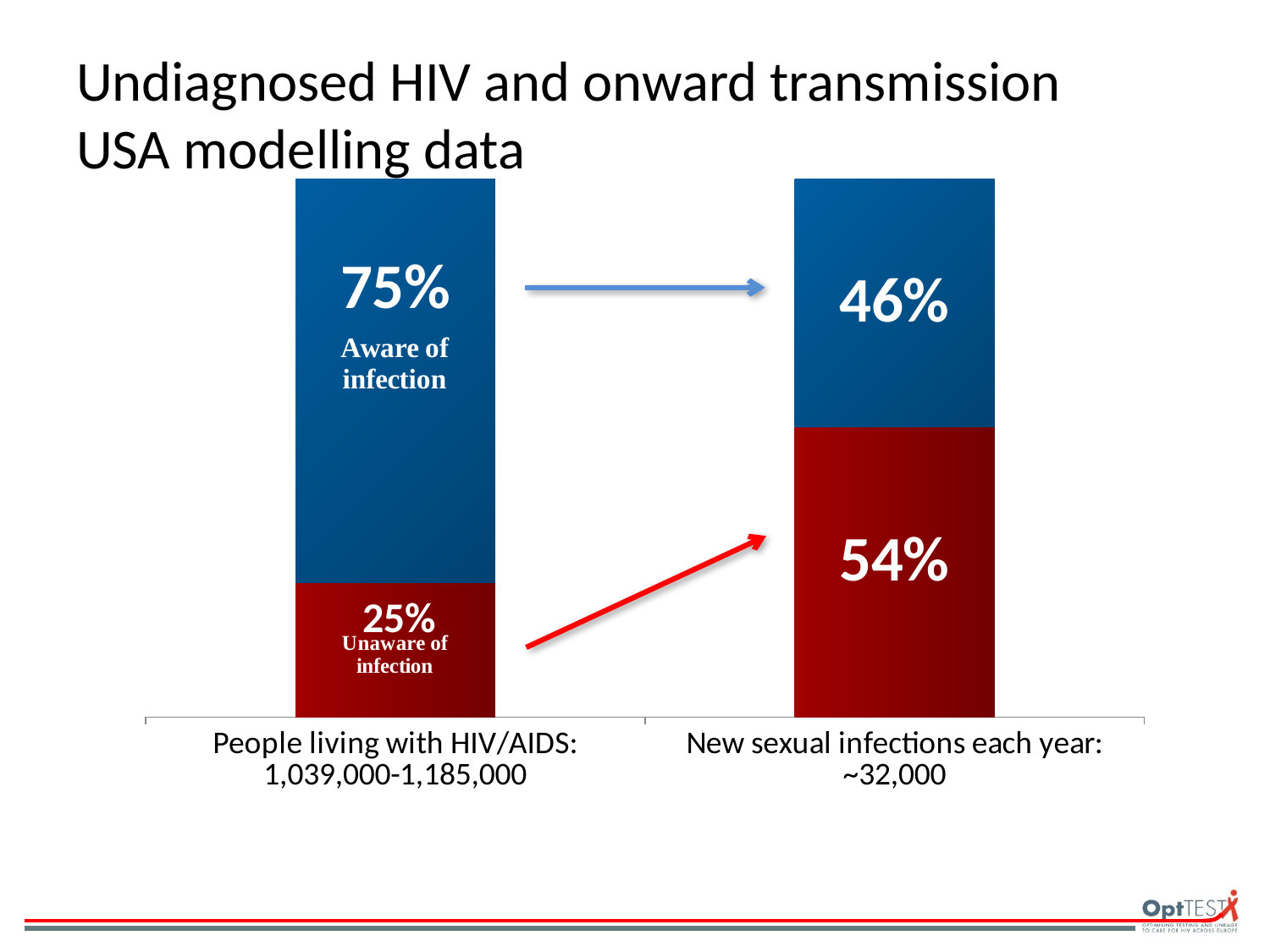
What share of new sexual infections each year comes from people aware of their infection? 46% What share of new sexual infections each year comes from people unaware of their infection? 54% What colour represents people unaware of infection in the chart? Red For new sexual infections each year, which is larger: the share from people aware of infection or from people unaware of infection? Unaware of infection How many bars (categories) are shown in the chart? 2 What percentage of people living with HIV/AIDS are aware of their infection? 75% What percentage of people living with HIV/AIDS are unaware of their infection? 25% What is the total of the stacked bar for people living with HIV/AIDS? 100% What kind of chart is shown on the slide? Stacked bar chart What is the difference between the unaware and aware shares of new sexual infections each year? 8% What is the difference between the aware and unaware percentages for people living with HIV/AIDS? 50% What is the approximate number of new sexual infections each year given in the category label? ~32,000